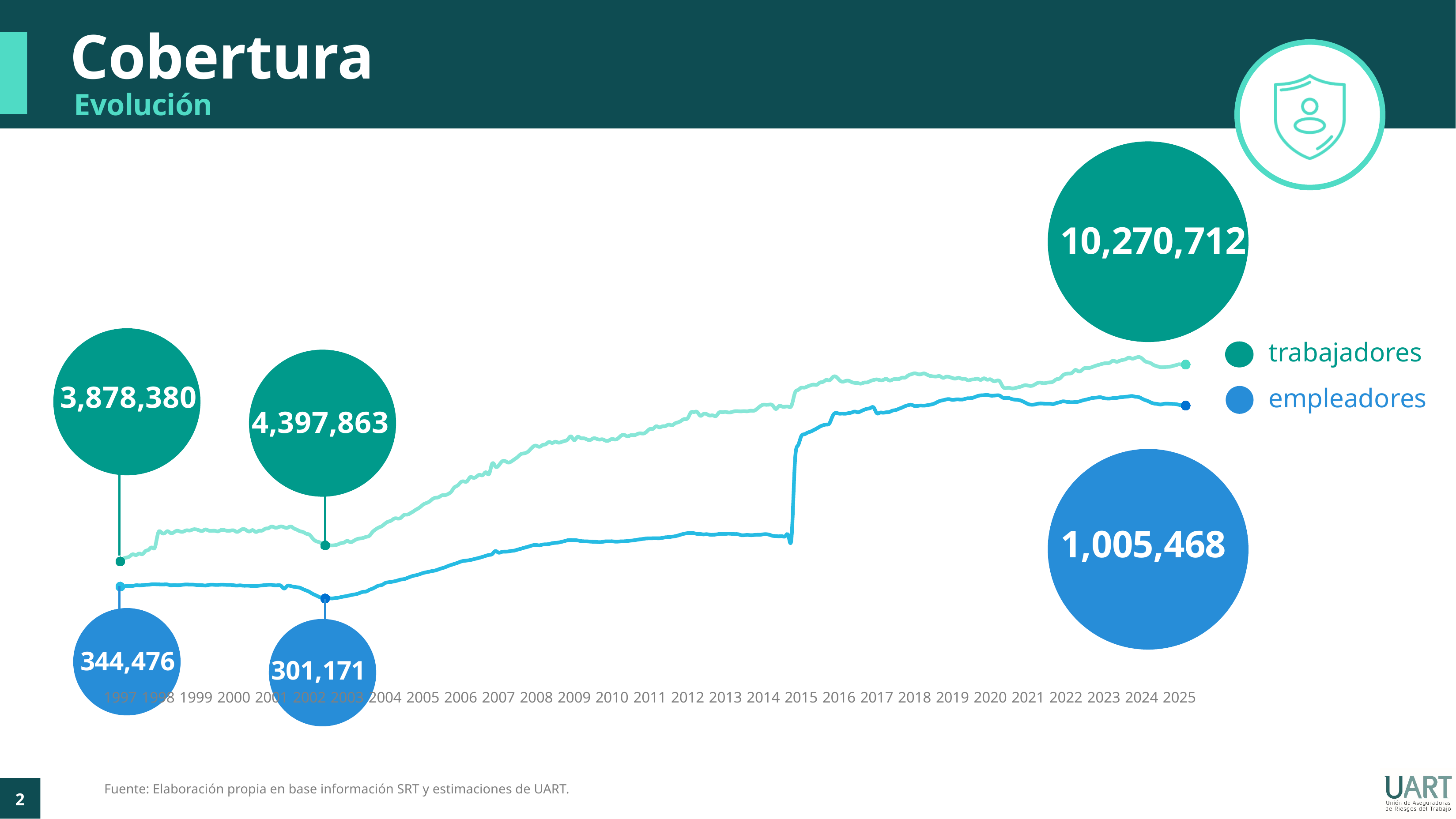
By how much did the trabajadores value increase from 1997 to 2025? 6,392,332 What is the value of empleadores shown for 2025? 1,005,468 How many series does the legend list? 2 By how much did the empleadores value increase from 1997 to 2025? 660,992 What is the value of trabajadores shown for 1997? 3,878,380 What are the two series named in the legend? trabajadores and empleadores Overall, does the trabajadores line rise or fall from 1997 to 2025? rise What is the value of empleadores shown for 1997? 344,476 What kind of chart is shown on the slide? line chart What value is shown in the second trabajadores callout from the left (at the dip around 2002–2003)? 4,397,863 What value is shown in the second empleadores callout from the left (at the dip around 2002–2003)? 301,171 What is the value of trabajadores shown for 2025? 10,270,712